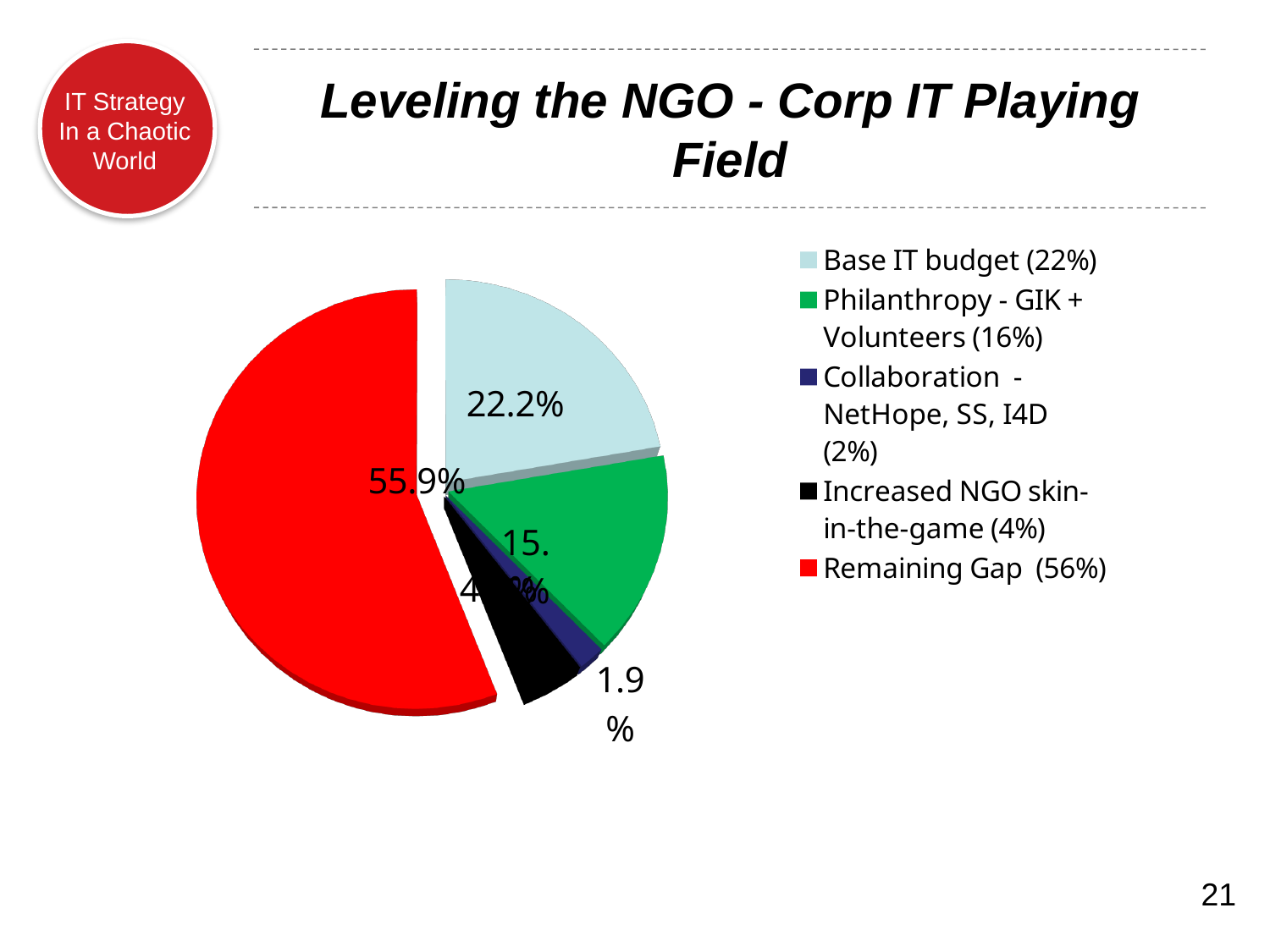
How many entries does the legend list? 5 What percentage does the legend give for Philanthropy - GIK + Volunteers? 16% Which category has the smallest slice of the pie? Collaboration - NetHope, SS, I4D What kind of chart is shown on the slide? Pie chart How many slices does the pie chart have? 5 What is the difference in percentage points between the Remaining Gap slice (55.9%) and the Base IT budget slice (22.2%)? 33.7 percentage points What is the data label shown on the Collaboration - NetHope, SS, I4D slice? 1.9% What colour is the Remaining Gap slice? Red What is the data label shown on the Base IT budget slice? 22.2% Which category has the largest slice of the pie? Remaining Gap Which slice is larger: Base IT budget or Philanthropy - GIK + Volunteers? Base IT budget What is the data label shown on the Remaining Gap slice? 55.9%